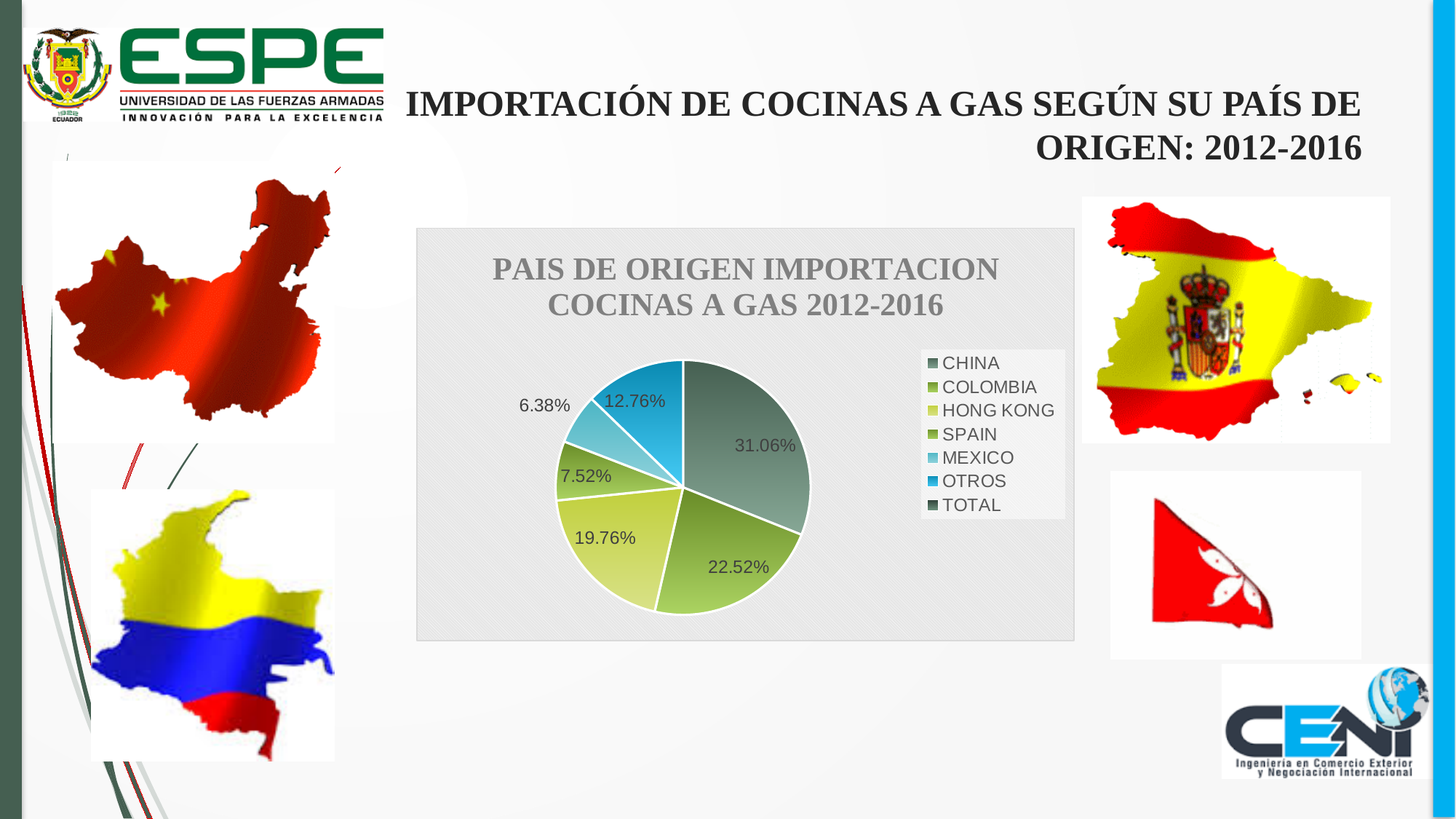
What is the difference in percentage points between CHINA and COLOMBIA? 8.54 What percentage is shown for MEXICO? 6.38% What is the title of the chart? PAIS DE ORIGEN IMPORTACION COCINAS A GAS 2012-2016 What type of chart is shown on the slide? Pie chart What percentage of the pie does CHINA account for? 31.06% Which country has the largest share of the pie? CHINA Which has a larger share, SPAIN or OTROS? OTROS What percentage is shown for OTROS? 12.76% Which labelled slice has the smallest share of the pie? MEXICO How many entries does the legend list? 7 What percentage is shown for HONG KONG? 19.76% What percentage is shown for COLOMBIA? 22.52%